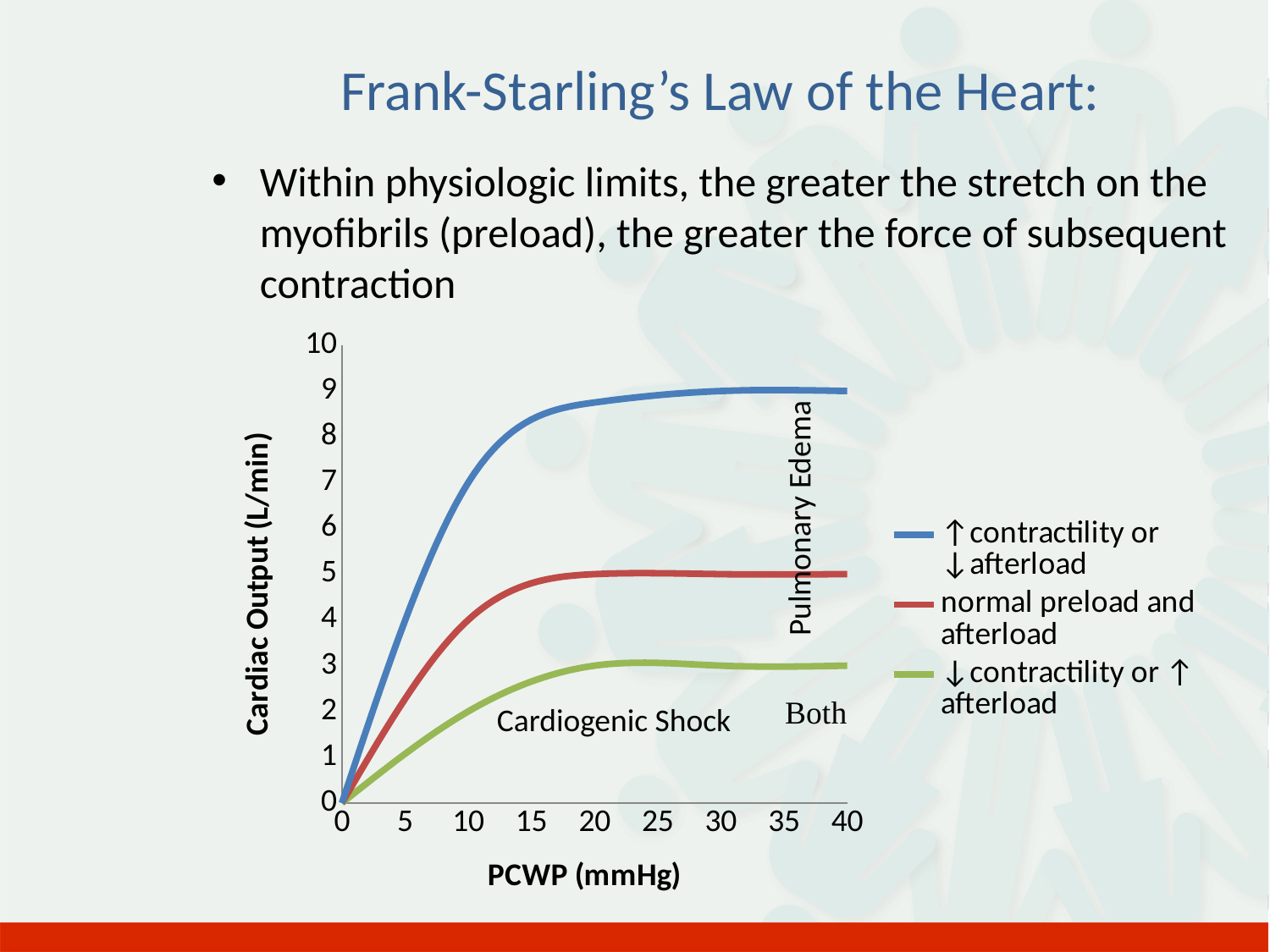
Is the cardiac output for the '↑ contractility or ↓ afterload' series at a PCWP of 40 mmHg greater or less than 8 L/min? greater Which series has the lowest cardiac output across the PCWP range? ↓ contractility or ↑ afterload At a PCWP of 20 mmHg, which series has the larger cardiac output: 'normal preload and afterload' or '↓ contractility or ↑ afterload'? normal preload and afterload How does cardiac output change as PCWP increases from 0 to 15 mmHg for the 'normal preload and afterload' series? rises Is the cardiac output for the '↓ contractility or ↑ afterload' series at a PCWP of 40 mmHg greater or less than 4 L/min? less Which series reaches the highest cardiac output? ↑ contractility or ↓ afterload How many series does the legend list? 3 What type of chart is shown on the slide? line chart What is the label of the y axis? Cardiac Output (L/min) Is the cardiac output for the 'normal preload and afterload' series at a PCWP of 40 mmHg greater or less than 6 L/min? less What is the cardiac output for all three series at a PCWP of 0 mmHg? 0 What is the label of the x axis? PCWP (mmHg)